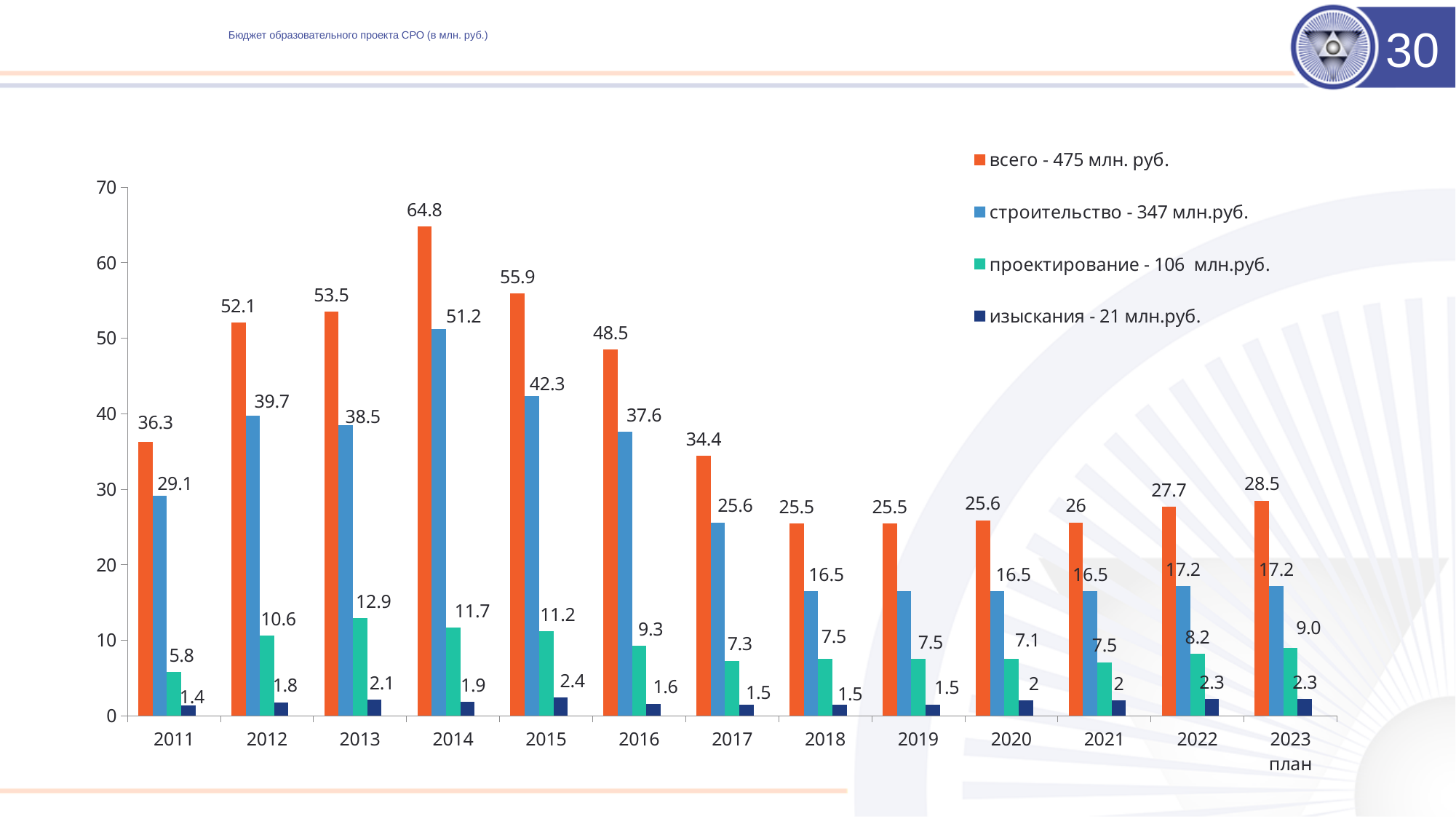
Which is larger: the "строительство" value for 2012 or for 2013? 2012 How many years (categories) are shown on the x axis? 13 What is the value of the "строительство" series for 2015? 42.3 What kind of chart is shown on the slide? bar chart What is the value of the "изыскания" series for 2011? 1.4 How many series does the legend list? 4 What is the value of the "проектирование" series for 2013? 12.9 Is the "всего" value for 2016 greater or less than 40? greater In which year is the "всего" value the highest? 2014 What is the difference between the "всего" values for 2014 and 2015? 8.9 What is the value of the "всего" series for 2014? 64.8 In which year is the "проектирование" value the lowest? 2011